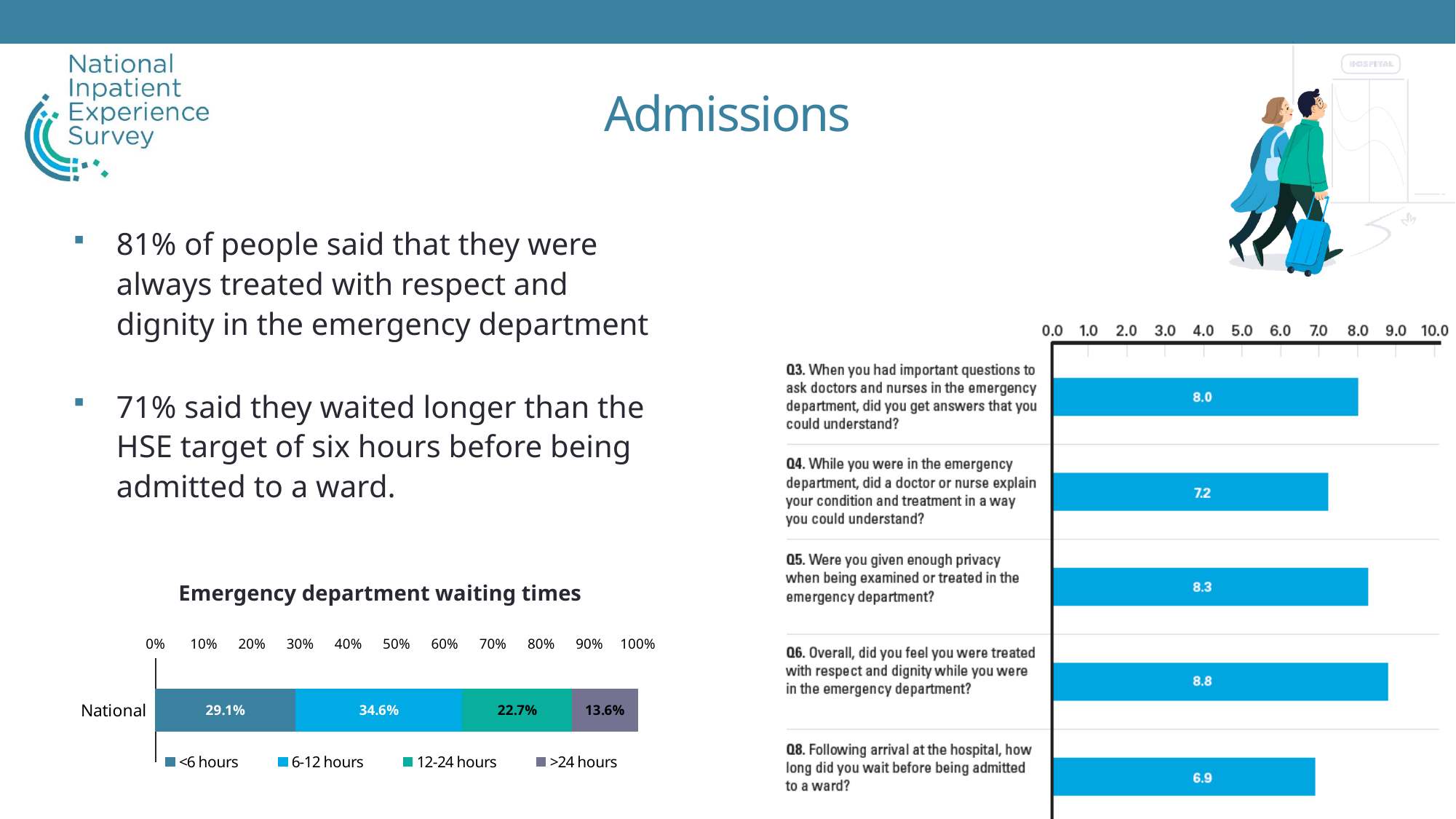
In the 'Emergency department waiting times' chart, which waiting time category has the smallest share? >24 hours In the chart on the right of the slide, what is the difference between the scores for Q5 and Q4? 1.1 In the 'Emergency department waiting times' chart, what is the difference between the <6 hours share and the 12-24 hours share? 6.4% In the 'Emergency department waiting times' chart, which waiting time category has the largest share? 6-12 hours In the chart on the right of the slide, what is the score for Q6 about being treated with respect and dignity in the emergency department? 8.8 In the 'Emergency department waiting times' chart, what percentage of people waited more than 24 hours? 13.6% In the chart on the right of the slide, what is the score for Q8 about how long you waited before being admitted to a ward? 6.9 In the 'Emergency department waiting times' chart, how many series does the legend list? 4 In the chart on the right of the slide, how many questions are plotted? 5 In the chart on the right of the slide, which question has the lowest score? Q8 In the 'Emergency department waiting times' chart, what percentage of people waited 6-12 hours? 34.6% What kind of chart is the 'Emergency department waiting times' chart? Stacked bar chart